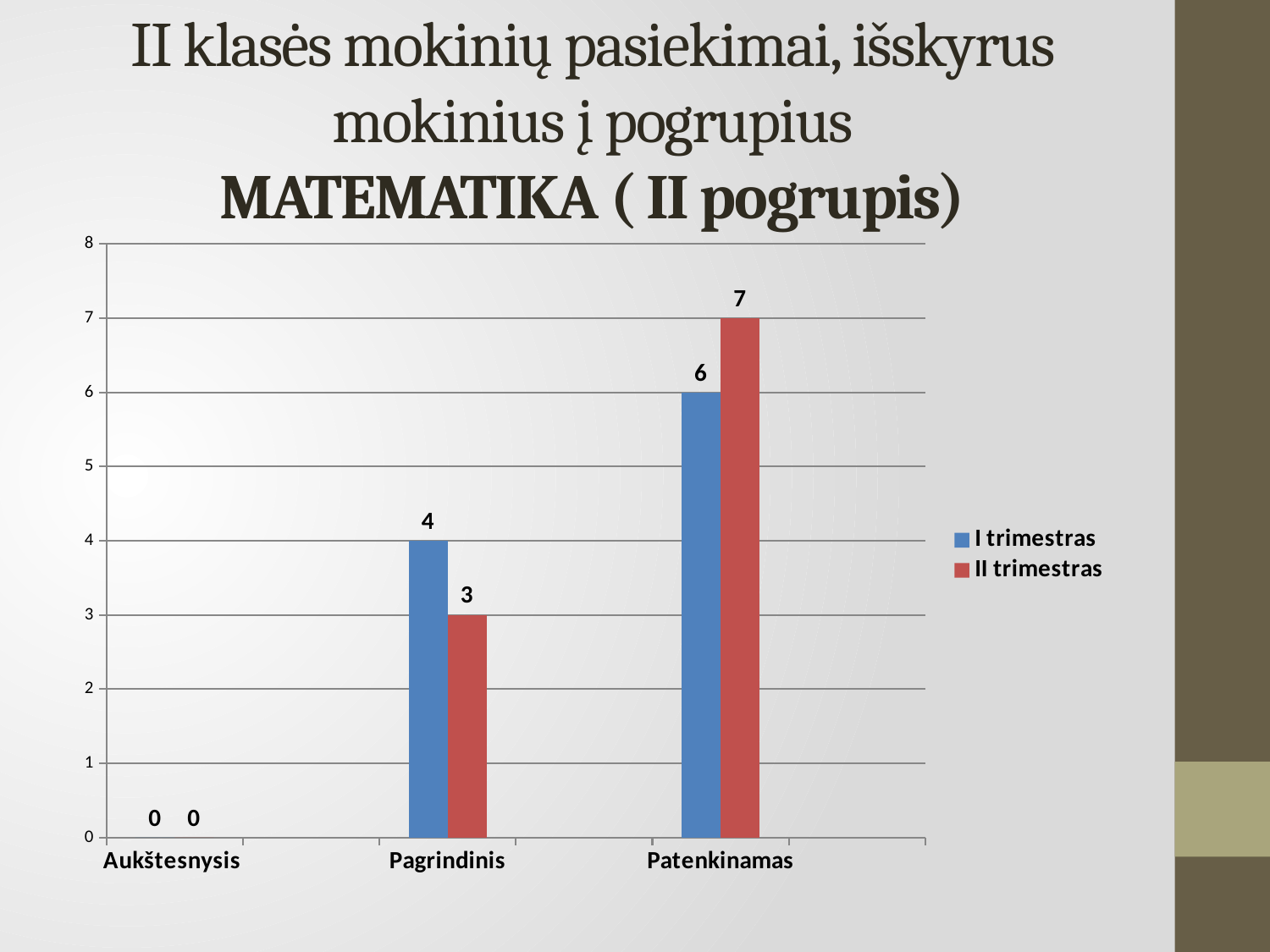
How many categories are shown on the x axis? 3 What is the value for Aukštesnysis in the I trimestras series? 0 What is the difference between the II trimestras and I trimestras values for Patenkinamas? 1 Which category has the lowest value in the I trimestras series? Aukštesnysis Which category has the highest value in the II trimestras series? Patenkinamas Do the I trimestras values rise or fall from Aukštesnysis to Patenkinamas? Rise What is the value for Pagrindinis in the I trimestras series? 4 For Pagrindinis, which series has the larger value, I trimestras or II trimestras? I trimestras What colour are the II trimestras bars? Red What is the value for Patenkinamas in the II trimestras series? 7 How many series does the legend list? 2 What kind of chart is shown on the slide? Bar chart